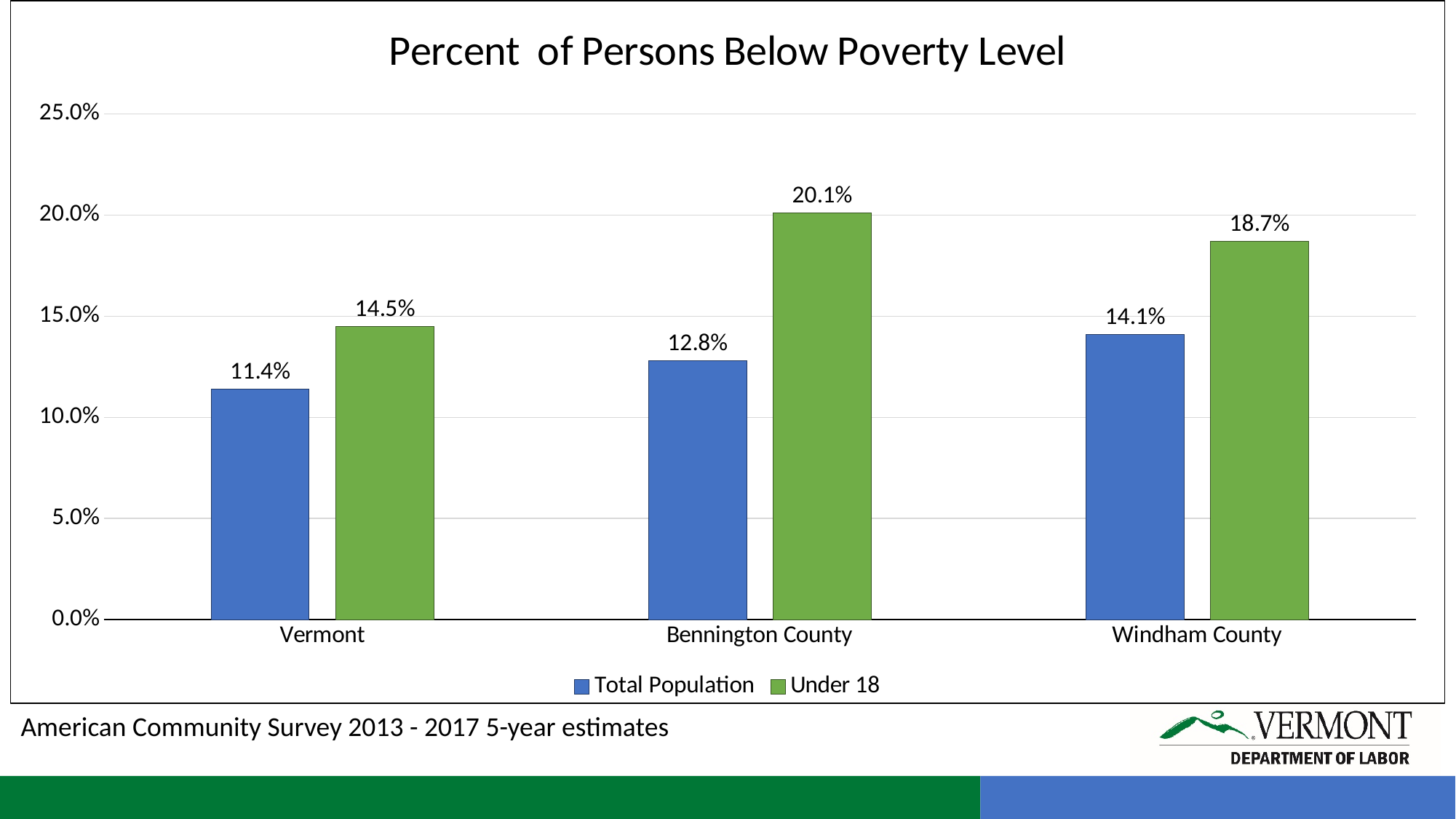
Which category has the lowest Total Population value? Vermont Which category has the highest Under 18 value? Bennington County What is the title of the chart? Percent of Persons Below Poverty Level How many series does the legend list? 2 What is the Under 18 value for Bennington County? 20.1% Is the Under 18 value for Bennington County greater or less than 20.0%? greater What is the difference between the Under 18 and Total Population values for Bennington County? 7.3% What kind of chart is shown? bar chart How many categories are shown on the x axis? 3 Which is larger: the Under 18 value for Windham County or the Under 18 value for Vermont? Windham County What is the Total Population value for Vermont? 11.4% What is the Total Population value for Windham County? 14.1%